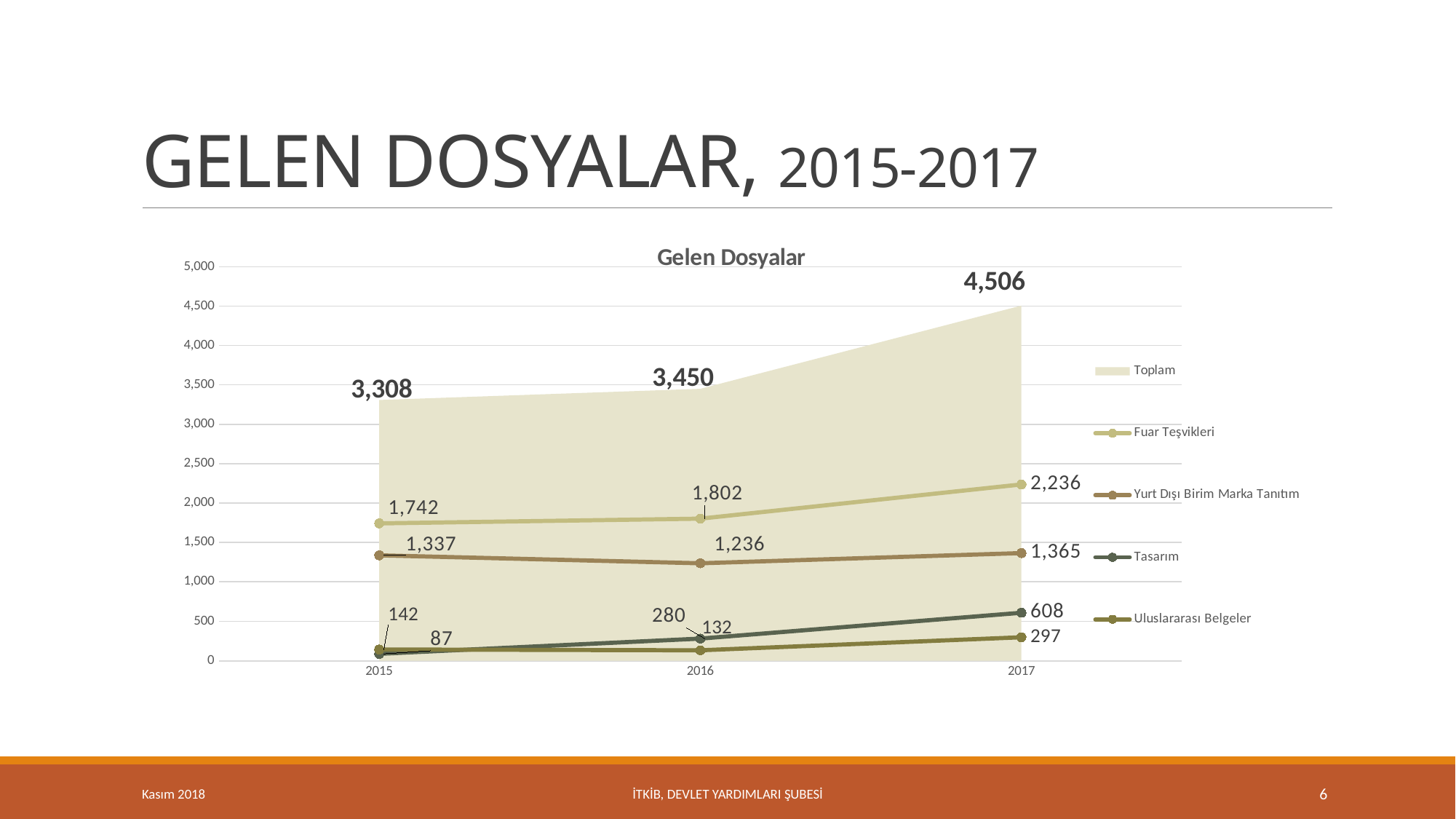
Does the Fuar Teşvikleri series rise or fall from 2015 to 2017? rise What is the value of Tasarım in 2017? 608 What is the value of Yurt Dışı Birim Marka Tanıtım in 2015? 1,337 How many series does the legend list? 5 In which year is the Toplam value highest? 2017 What is the title of the chart? Gelen Dosyalar What is the Toplam value for 2017? 4,506 How many years are shown on the x axis? 3 In which year is the Tasarım value lowest? 2015 What is the difference between the Toplam values for 2017 and 2016? 1,056 What is the value of Fuar Teşvikleri in 2016? 1,802 Which is larger in 2015: Tasarım or Uluslararası Belgeler? Uluslararası Belgeler